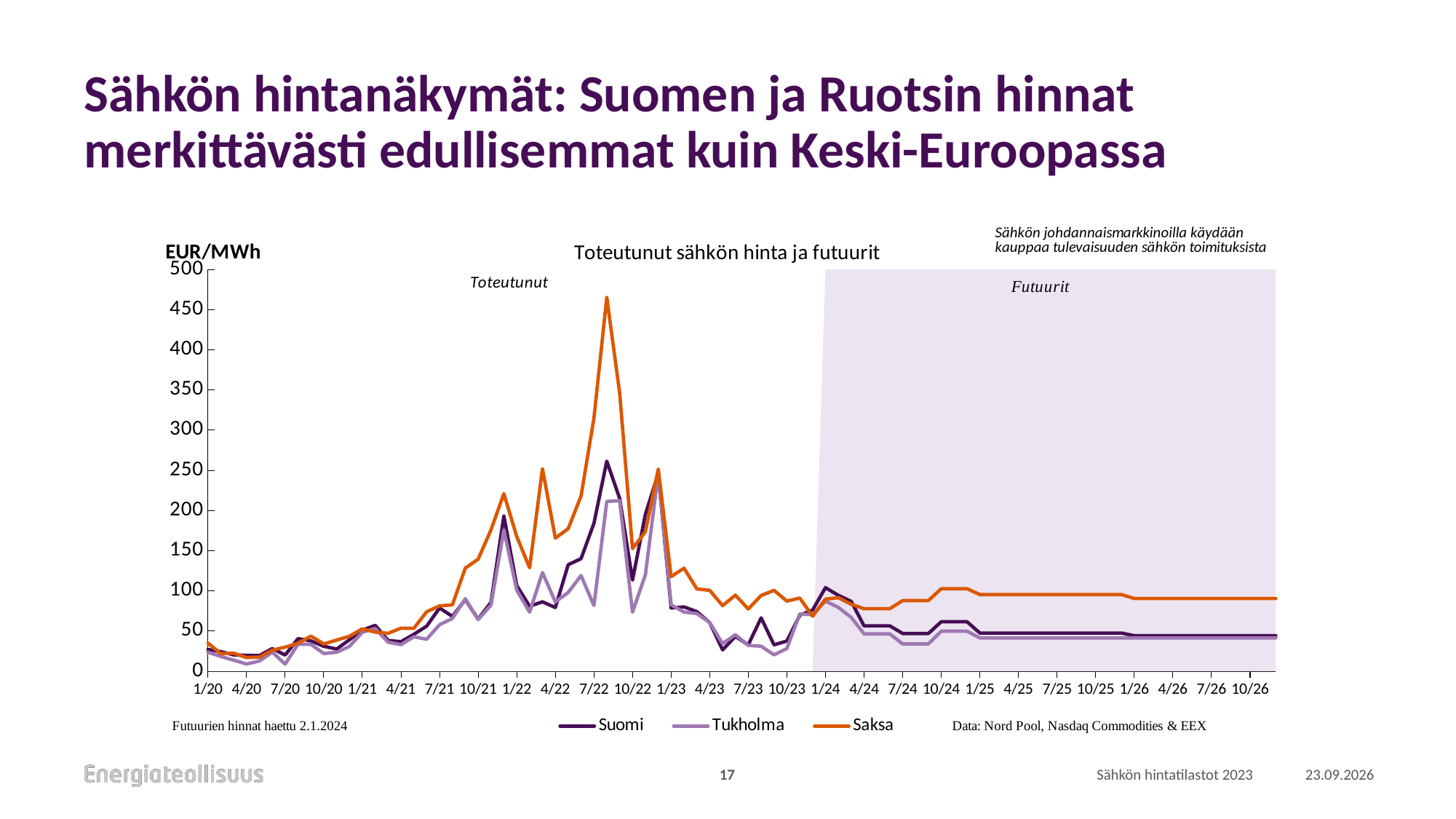
How many series does the legend list? 3 Is the peak value of the Saksa line greater or less than 400? greater What kind of chart is shown on the slide? line chart Is the value for Suomi at 10/26 greater or less than 100? less What are the series names listed in the legend? Suomi, Tukholma, Saksa Which series reaches the highest value on the chart? Saksa At 10/26, which is higher, Saksa or Suomi? Saksa Is the value for Saksa at 10/26 greater or less than 150? less Does the Saksa line generally rise or fall from 1/20 to its peak in 2022? rise What is the title of the chart? Toteutunut sähkön hinta ja futuurit At 4/24, which is lower, Suomi or Tukholma? Tukholma